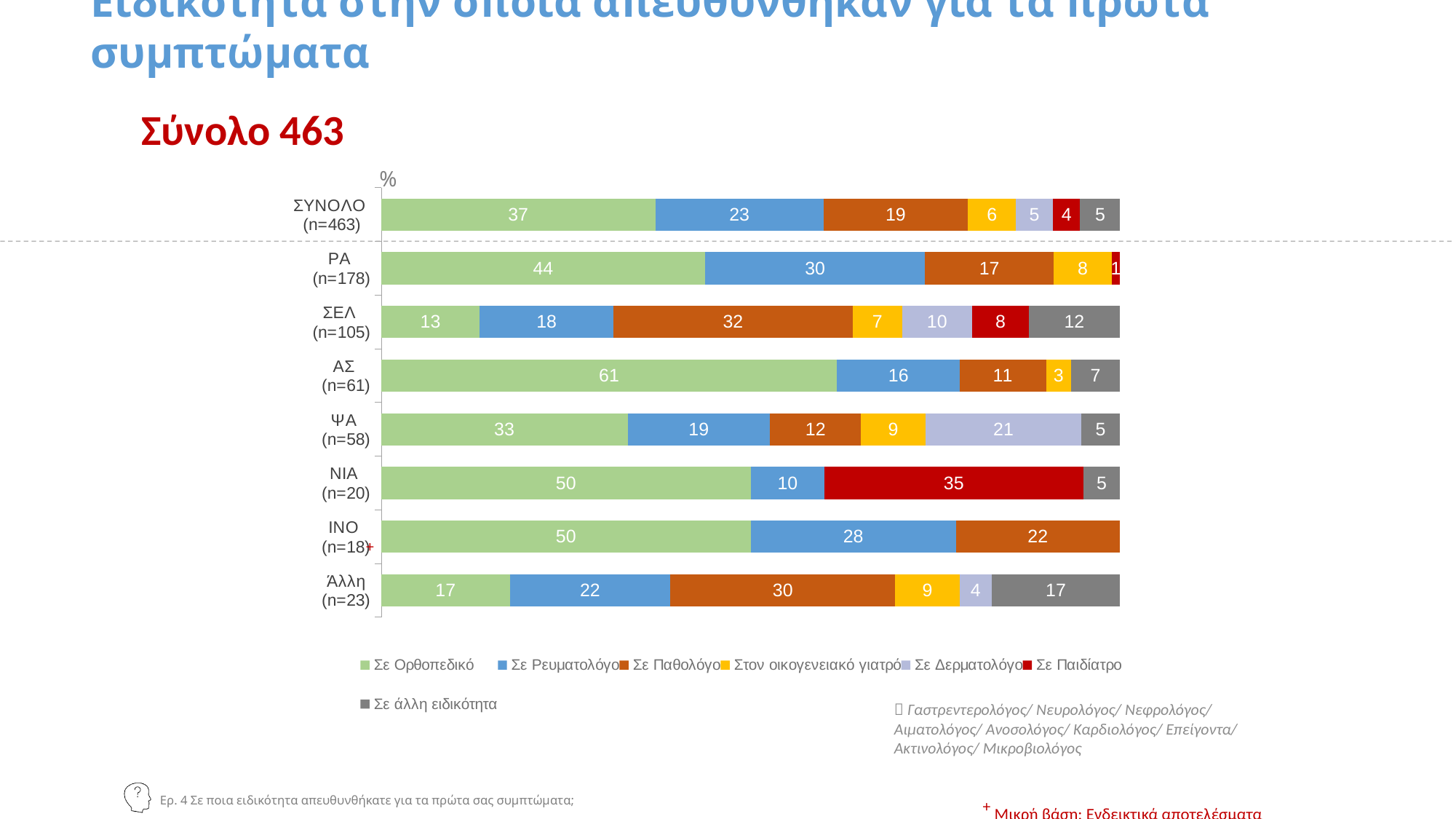
What is the value for Σε Δερματολόγο in the ΨΑ (n=58) row? 21 What is the value for Σε Παθολόγο in the ΣΕΛ (n=105) row? 32 Which category has the highest value for Σε Ορθοπεδικό? ΑΣ (n=61) What is the value for Σε Παιδίατρο in the ΝΙΑ (n=20) row? 35 What is the value for Σε Ορθοπεδικό in the ΑΣ (n=61) row? 61 How many categories (rows) are plotted in the chart? 8 What is the total shown in the red heading above the chart? Σύνολο 463 What is the difference between the Σε Ρευματολόγο values for ΡΑ (n=178) and ΣΥΝΟΛΟ (n=463)? 7 Which category has the lowest value for Σε Ορθοπεδικό? ΣΕΛ (n=105) Which is larger: the Σε Παθολόγο value for Άλλη (n=23) or for ΙΝΟ (n=18)? Άλλη (n=23) What type of chart is shown on the slide? Stacked bar chart How many series does the legend list? 7